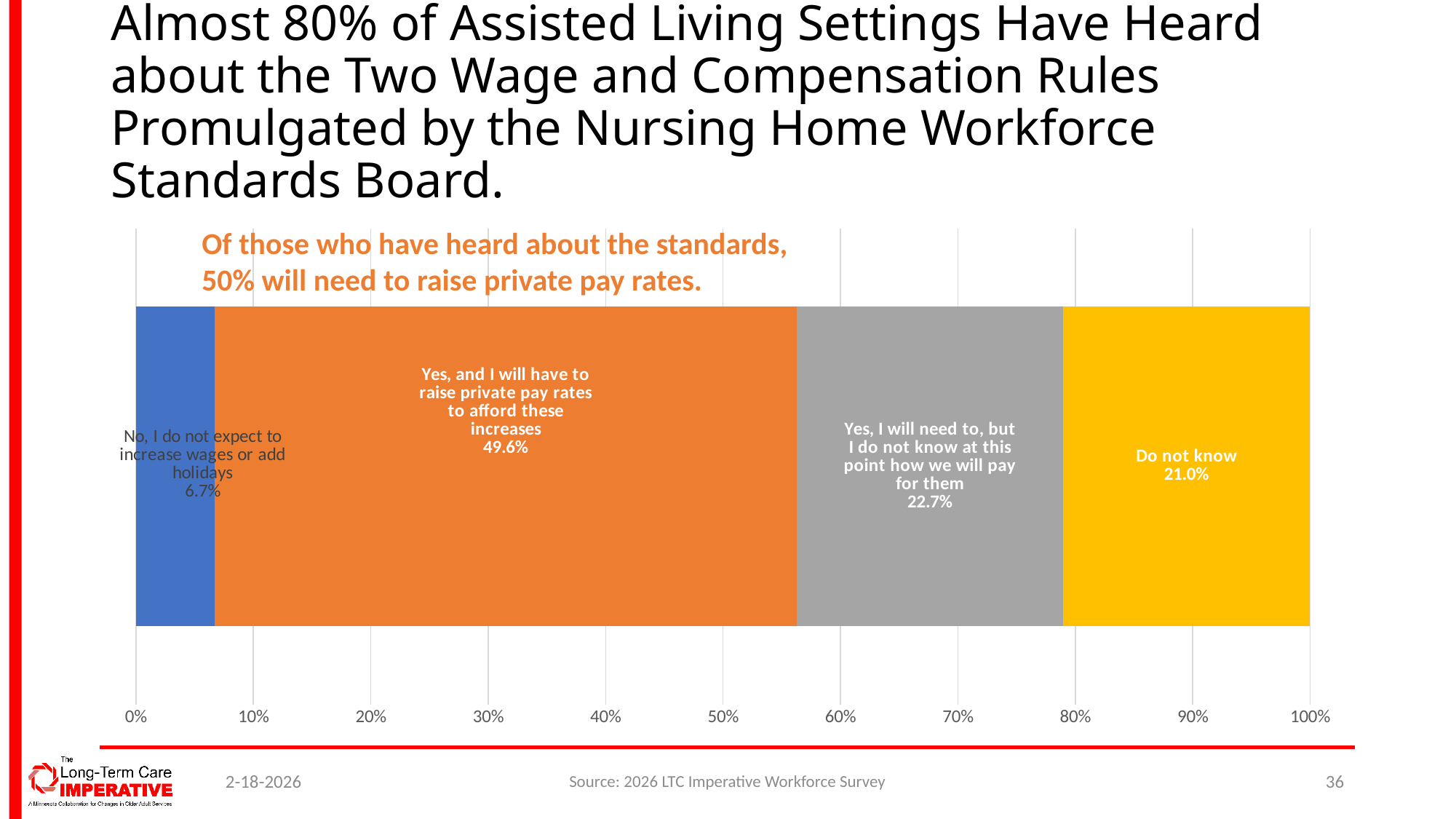
How many response categories are shown in the stacked bar? 4 What is the combined share of the two "Yes" responses? 72.3% What colour is the segment for "Do not know"? Yellow What percentage of respondents said "Yes, I will need to, but I do not know at this point how we will pay for them"? 22.7% What percentage of respondents answered "Do not know"? 21.0% Which response category has the smallest share? No, I do not expect to increase wages or add holidays What percentage of respondents said "Yes, and I will have to raise private pay rates to afford these increases"? 49.6% What percentage of respondents said "No, I do not expect to increase wages or add holidays"? 6.7% What type of chart is shown on the slide? Stacked bar chart Which response category has the largest share? Yes, and I will have to raise private pay rates to afford these increases What is the difference in percentage points between "Yes, and I will have to raise private pay rates to afford these increases" and "Do not know"? 28.6 percentage points Which is larger: the share for "Do not know" or the share for "Yes, I will need to, but I do not know at this point how we will pay for them"? Yes, I will need to, but I do not know at this point how we will pay for them